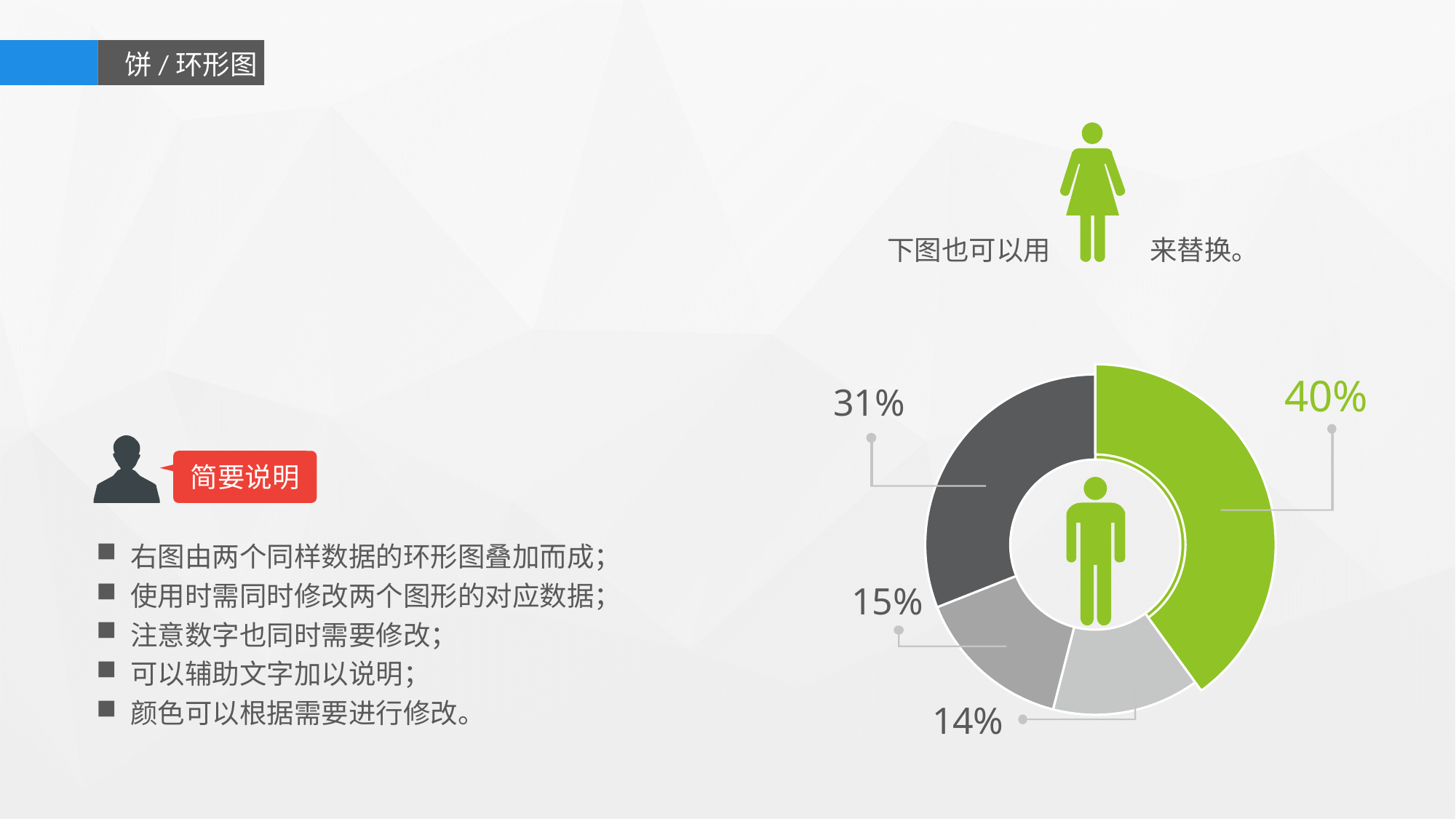
What is the largest percentage labelled on the donut chart? 40% Which colour is used for the 40% slice of the donut chart? Green Is the share of the dark gray slice greater or less than 30%? greater How many slices does the donut chart have? 4 What is the difference between the largest slice (40%) and the second largest slice (31%)? 9 percentage points Which slice is larger: the one labelled 15% or the one labelled 14%? 15% What kind of chart is shown on the right of the slide? Donut chart What is the combined share of the two smallest slices (15% and 14%)? 29% What percentage is shown for the green slice of the donut chart? 40% What is the smallest percentage labelled on the donut chart? 14% What percentage is shown for the dark gray slice of the donut chart? 31% What icon is placed in the centre of the donut chart? A green person (male) figure